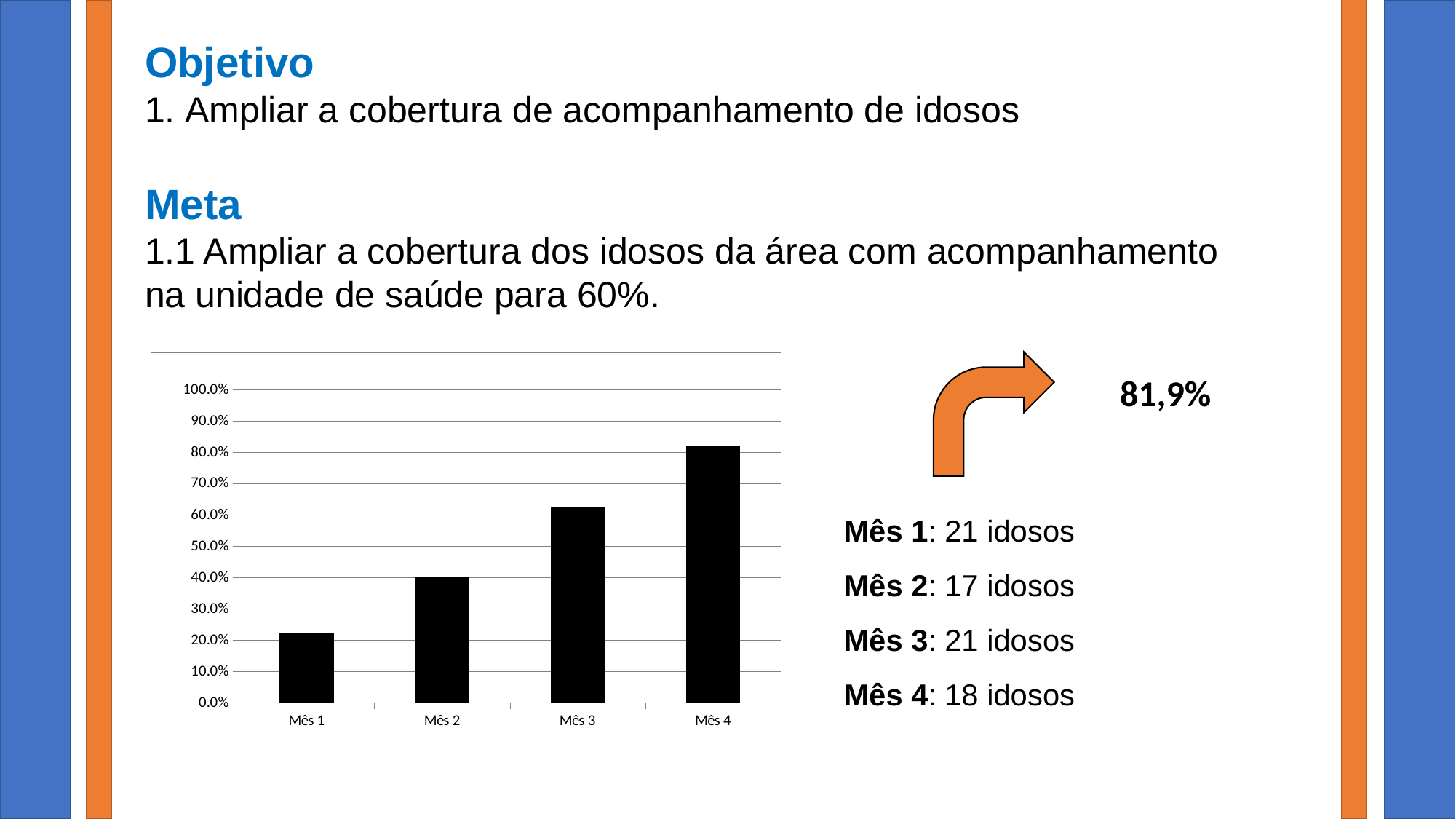
Is the value for Mês 2 greater or less than 50.0%? less What colour are the bars in the chart? black Is the value for Mês 3 greater or less than 50.0%? greater What kind of chart is shown on the slide? bar chart Is the value for Mês 4 greater or less than 70.0%? greater Which month has the highest bar on the chart? Mês 4 Which month has the lowest bar on the chart? Mês 1 Do the values rise or fall from Mês 1 to Mês 4? rise Which is larger, the value for Mês 2 or the value for Mês 3? Mês 3 How many categories (months) are plotted on the chart? 4